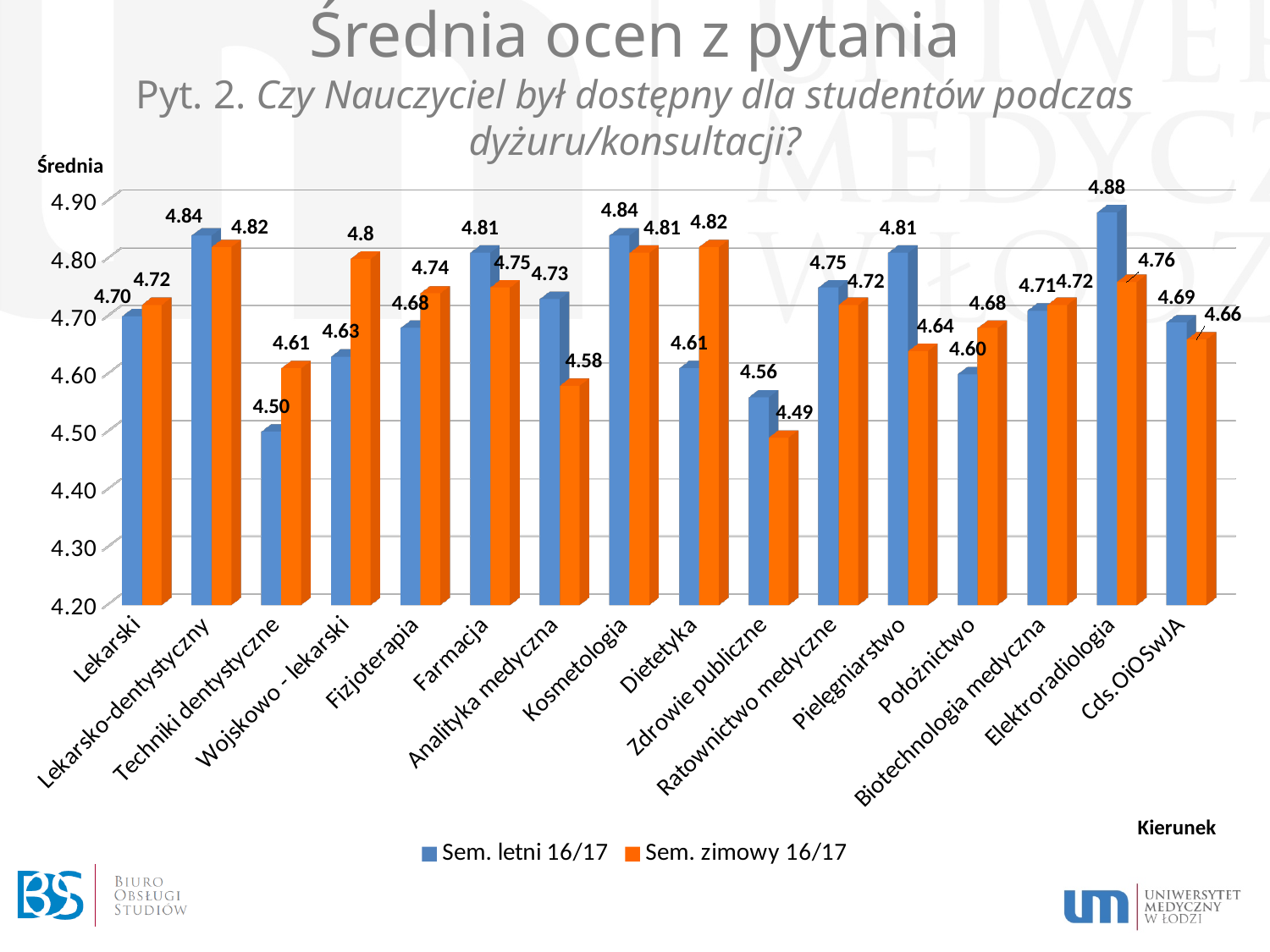
Which category has the highest value in the Sem. letni 16/17 series? Elektroradiologia Which category has the lowest value in the Sem. letni 16/17 series? Techniki dentystyczne What is the value for Zdrowie publiczne in the Sem. zimowy 16/17 series? 4.49 What kind of chart is shown on the slide? bar chart How many categories (kierunki) are shown on the x axis? 16 Is the Sem. letni 16/17 value for Techniki dentystyczne greater or less than 4.60? less What is the value for Elektroradiologia in the Sem. letni 16/17 series? 4.88 What is the difference between the Sem. letni 16/17 and Sem. zimowy 16/17 values for Pielęgniarstwo? 0.17 For Dietetyka, which series has the larger value: Sem. letni 16/17 or Sem. zimowy 16/17? Sem. zimowy 16/17 Which category has the lowest value in the Sem. zimowy 16/17 series? Zdrowie publiczne How many series does the legend list? 2 What is the value for Wojskowo - lekarski in the Sem. zimowy 16/17 series? 4.8